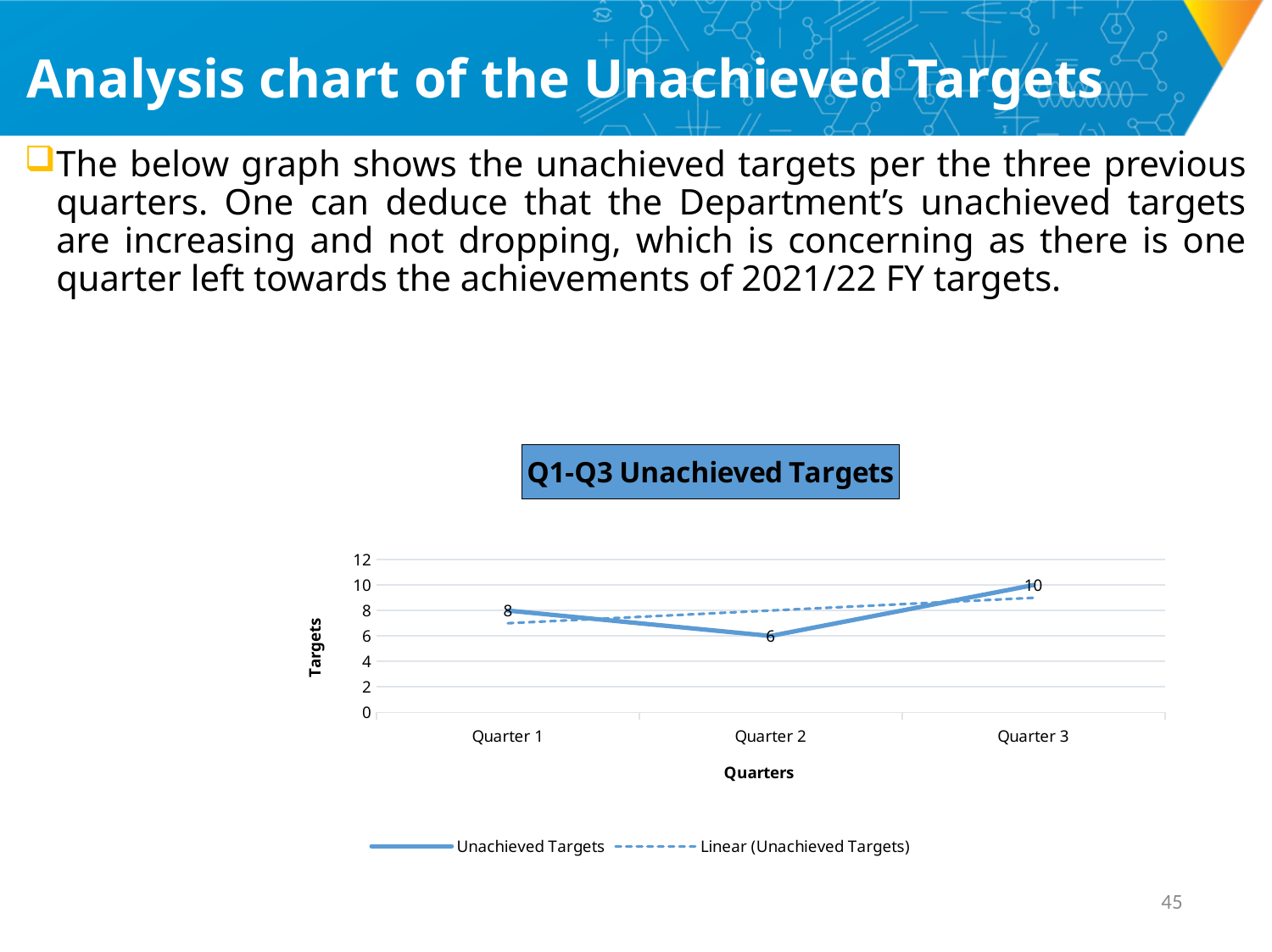
How many entries does the legend list? 2 What is the difference in Unachieved Targets between Quarter 3 and Quarter 2? 4 What is the title of the chart? Q1-Q3 Unachieved Targets What is the value of Unachieved Targets for Quarter 1? 8 Which quarter has the highest number of Unachieved Targets? Quarter 3 Which quarter has the lowest number of Unachieved Targets? Quarter 2 What is the value of Unachieved Targets for Quarter 3? 10 What kind of chart is shown? Line chart How many quarters are plotted on the x axis? 3 Which has more Unachieved Targets, Quarter 1 or Quarter 2? Quarter 1 What is the value of Unachieved Targets for Quarter 2? 6 Does the Unachieved Targets line rise or fall from Quarter 2 to Quarter 3? Rise